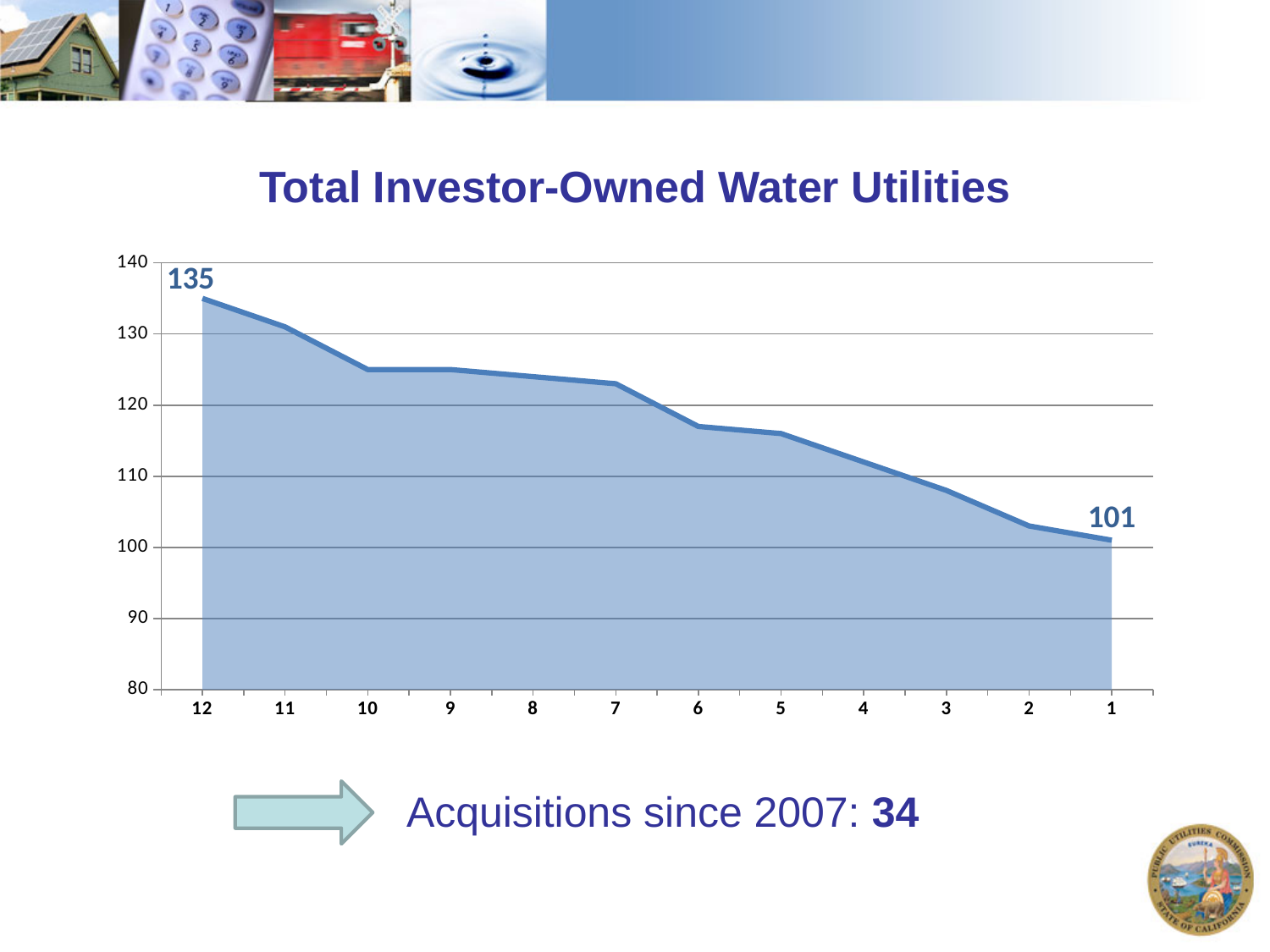
What kind of chart is shown? area chart Is the value at x-axis label 6 greater or less than 120? less How many points are plotted along the x axis? 12 Do the values rise or fall moving from left to right along the x axis? fall Which x-axis category has the lowest value? 1 What is the value at x-axis label 12? 135 Which x-axis category has the highest value? 12 What is the difference between the value at 12 and the value at 1? 34 Which is larger, the value at 12 or the value at 1? 12 Is the value at x-axis label 10 greater or less than 120? greater What is the title of the chart? Total Investor-Owned Water Utilities What is the value at x-axis label 1? 101